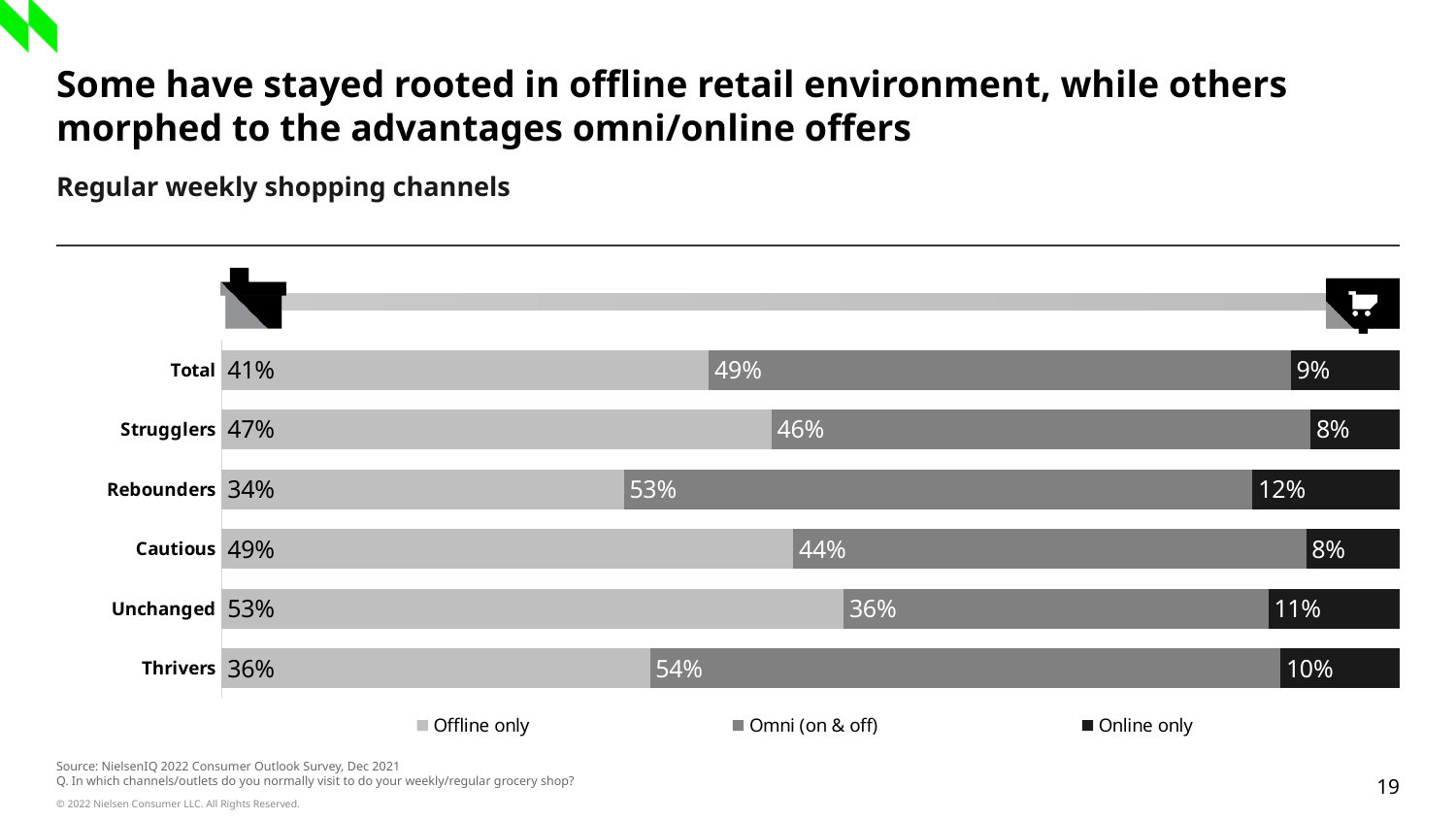
How many groups (categories) are shown on the chart? 6 Which is larger: the Offline only value for Struggler or for Thrivers? Strugglers Which group has the highest Offline only share? Unchanged What is the difference between the Omni (on & off) values for Rebounders and Cautious? 9 percentage points What is the Omni (on & off) value for Thrivers? 54% Which series is shown in the darkest colour in the legend? Online only What kind of chart is shown on the slide? Stacked bar chart How many series does the legend list? 3 What is the Offline only value for Rebounders? 34% Which group has the lowest Online only share? Strugglers and Cautious (both 8%) What is the Online only value for Unchanged? 11% What is the total of the stacked bar for Total? 99%